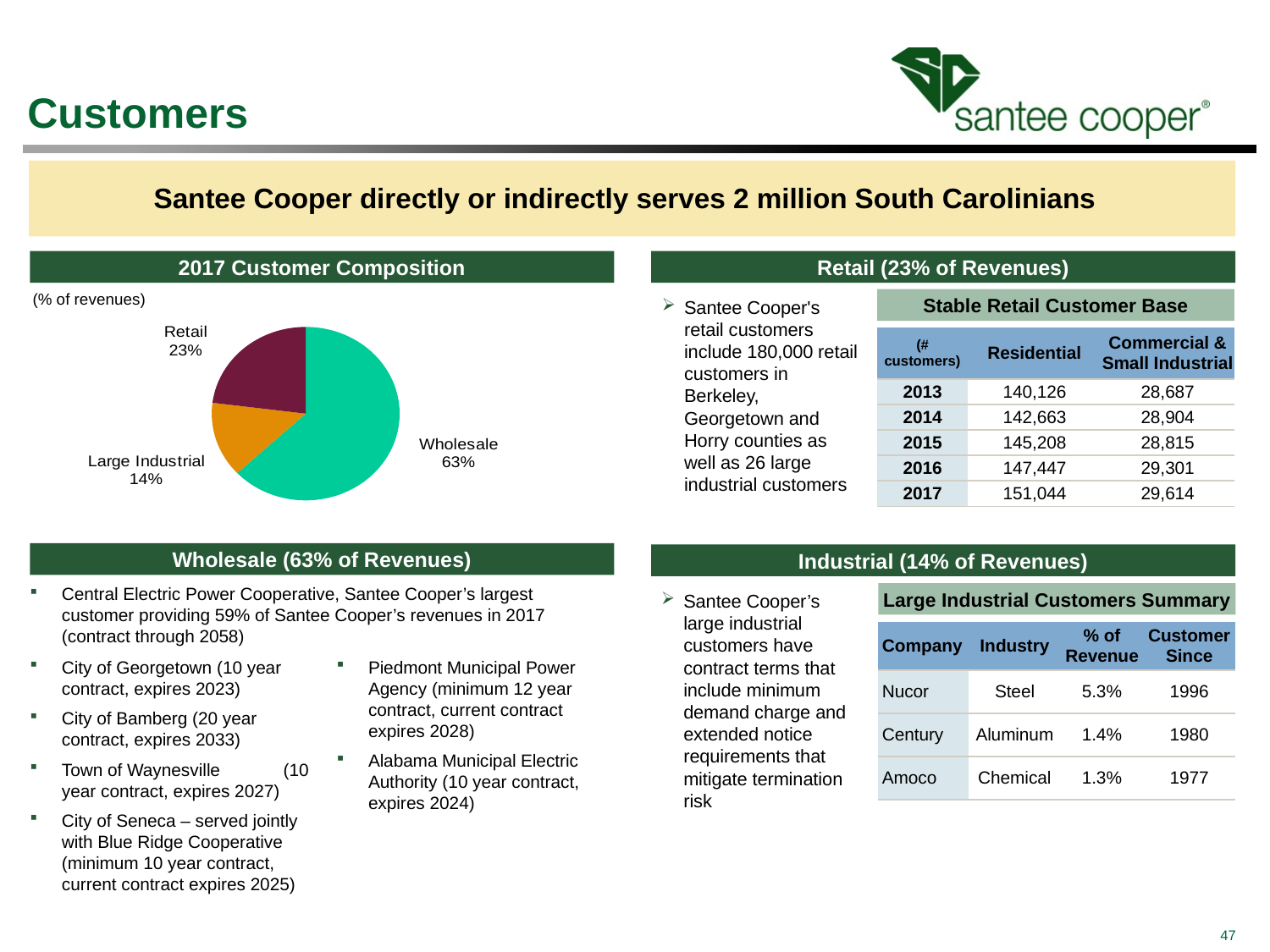
What is the title of the pie chart on the slide? 2017 Customer Composition What kind of chart is shown under "2017 Customer Composition"? pie chart What unit does the note above the 2017 Customer Composition pie chart say the values are in? % of revenues How many slices does the 2017 Customer Composition pie chart have? 3 In the 2017 Customer Composition pie chart, what share of revenues comes from Wholesale? 63% Which slice of the 2017 Customer Composition pie chart is the smallest? Large Industrial In the 2017 Customer Composition pie chart, what share of revenues comes from Retail? 23% In the 2017 Customer Composition pie chart, how many percentage points larger is Retail than Large Industrial? 9 Which slice of the 2017 Customer Composition pie chart is the largest? Wholesale In the 2017 Customer Composition pie chart, what share of revenues comes from Large Industrial? 14% In the 2017 Customer Composition pie chart, which is larger: Retail or Large Industrial? Retail In the 2017 Customer Composition pie chart, how many percentage points larger is Wholesale than Retail? 40